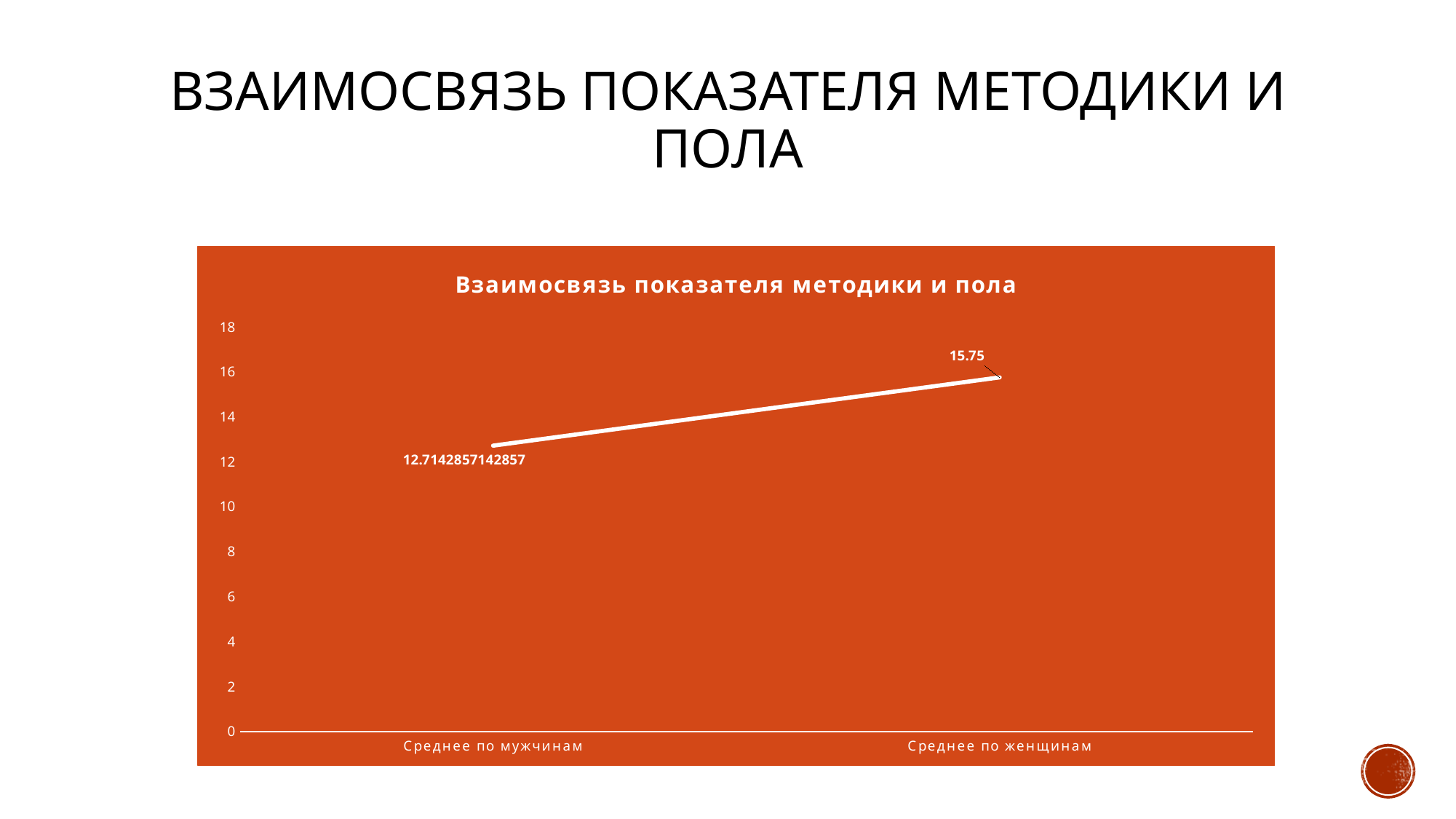
Is the value for Среднее по женщинам greater or less than 14? greater What is the title of the chart? Взаимосвязь показателя методики и пола Is the value for Среднее по мужчинам greater or less than 14? less Which category has the highest value? Среднее по женщинам What is the value for Среднее по женщинам? 15.75 What is the highest value shown on the y axis? 18 What kind of chart is shown on the slide? line chart What is the value for Среднее по мужчинам? 12.7142857142857 Which is larger, the value for Среднее по мужчинам or Среднее по женщинам? Среднее по женщинам Do the values rise or fall from Среднее по мужчинам to Среднее по женщинам? rise How many categories are shown on the x axis? 2 Which category has the lowest value? Среднее по мужчинам